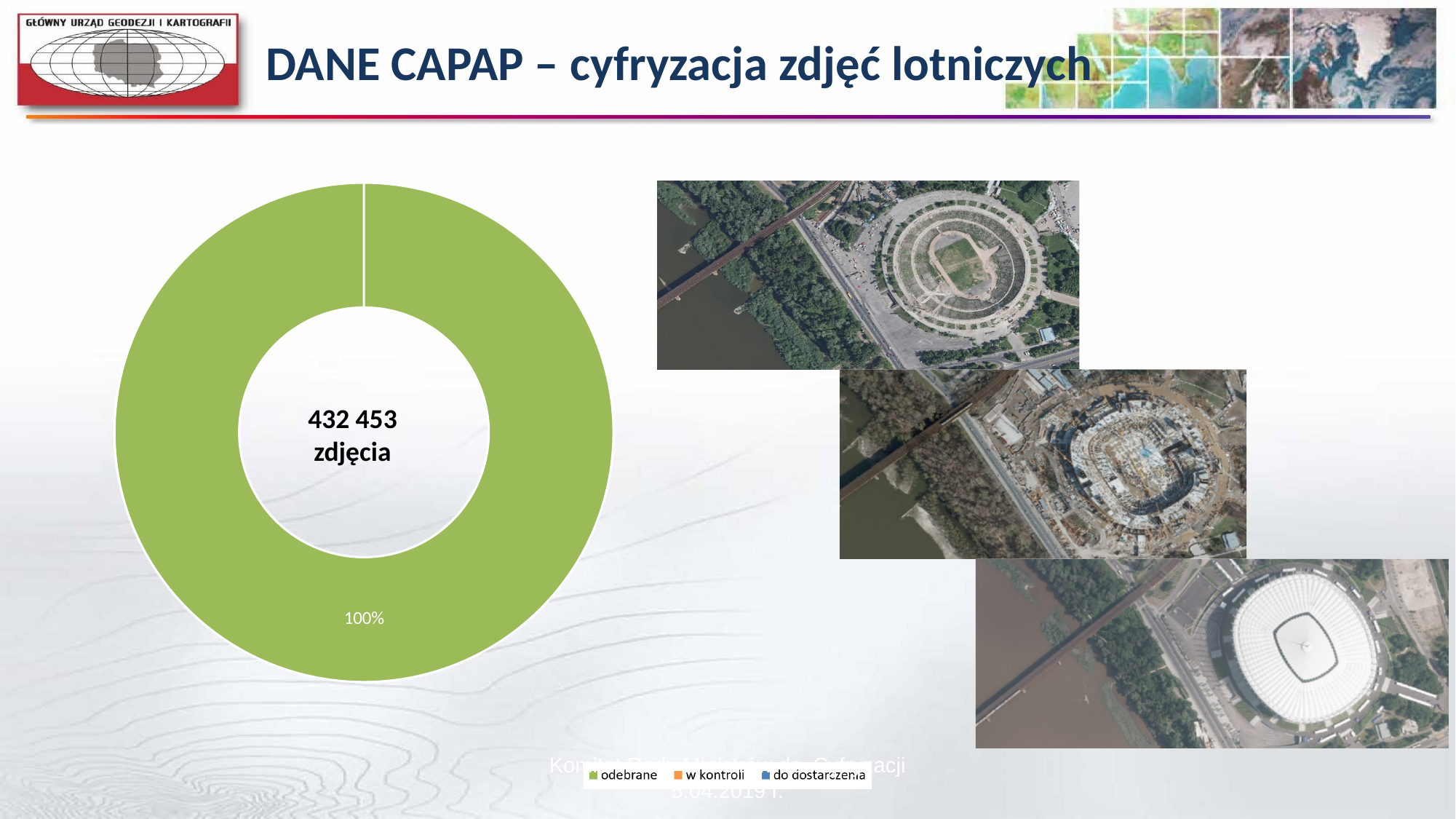
Is the share of 'odebrane' greater or less than 50%? greater How many entries does the chart legend list? 3 What is the title of the slide containing the chart? DANE CAPAP – cyfryzacja zdjęć lotniczych Which legend entry is shown in orange? w kontroli What kind of chart is shown on the slide? doughnut chart What colour is the 'odebrane' slice in the doughnut chart? green What number is printed in the centre of the doughnut chart? 432 453 zdjęcia Which category has the largest share in the doughnut chart? odebrane What share of the doughnut chart does the 'odebrane' slice take? 100%